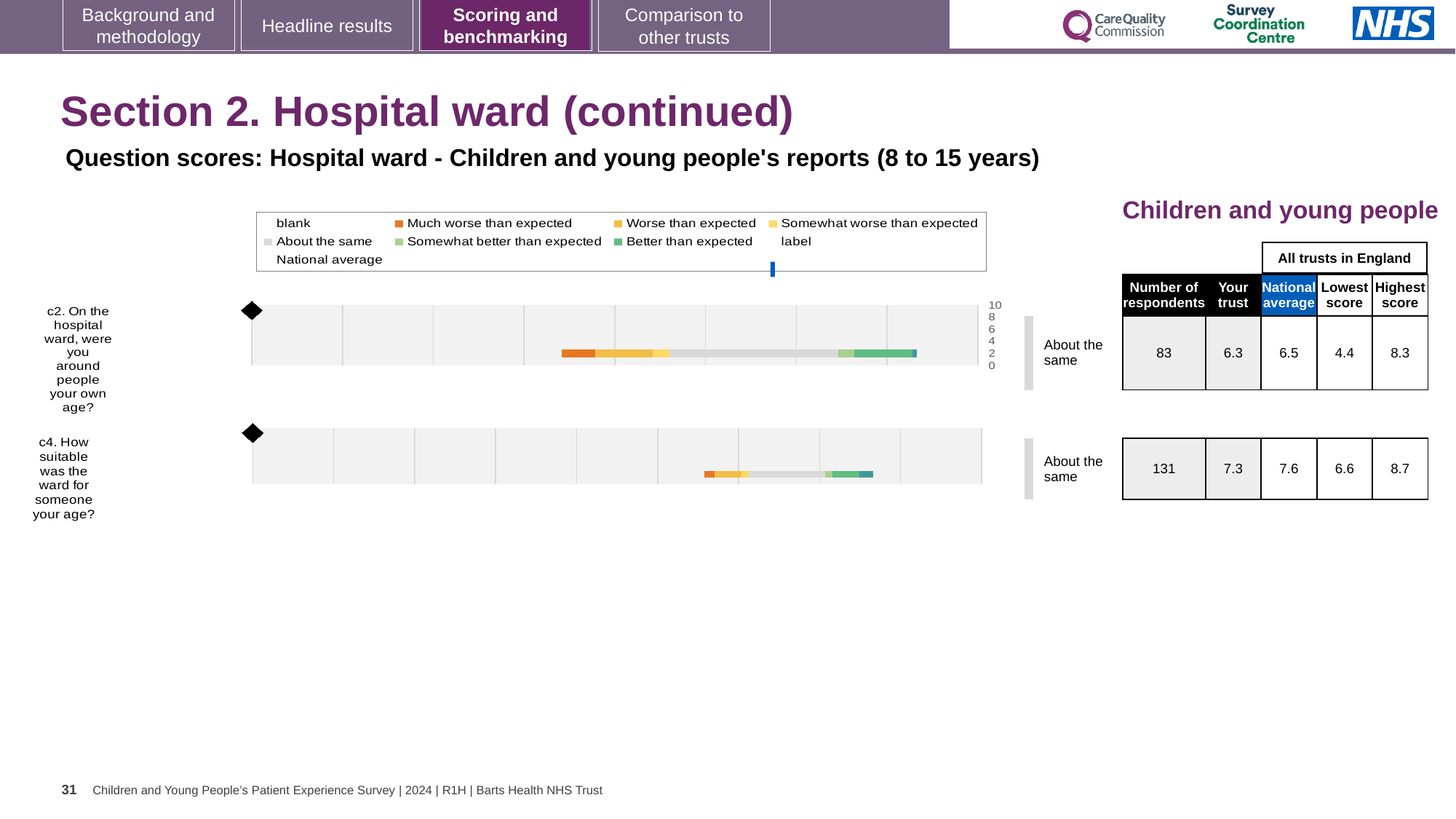
What is the lowest score across all trusts in England for question c4? 6.6 What kind of chart is used to show the question scores on this slide? bar chart What colour represents 'Much worse than expected' in the chart legend? Orange How many respondents answered question c2? 83 What is the difference between the highest and lowest trust scores for question c2? 3.9 What benchmark category is shown for question c2? About the same Which question has the higher 'Your trust' score, c2 or c4? c4 By how much does the national average exceed the trust's score for question c4? 0.3 What is the 'Your trust' score for question c2 (On the hospital ward, were you around people your own age?)? 6.3 Which question has the higher highest score across all trusts in England? c4 What is the national average score for question c4 (How suitable was the ward for someone your age?)? 7.6 How many questions are plotted in the benchmark charts on this slide? 2